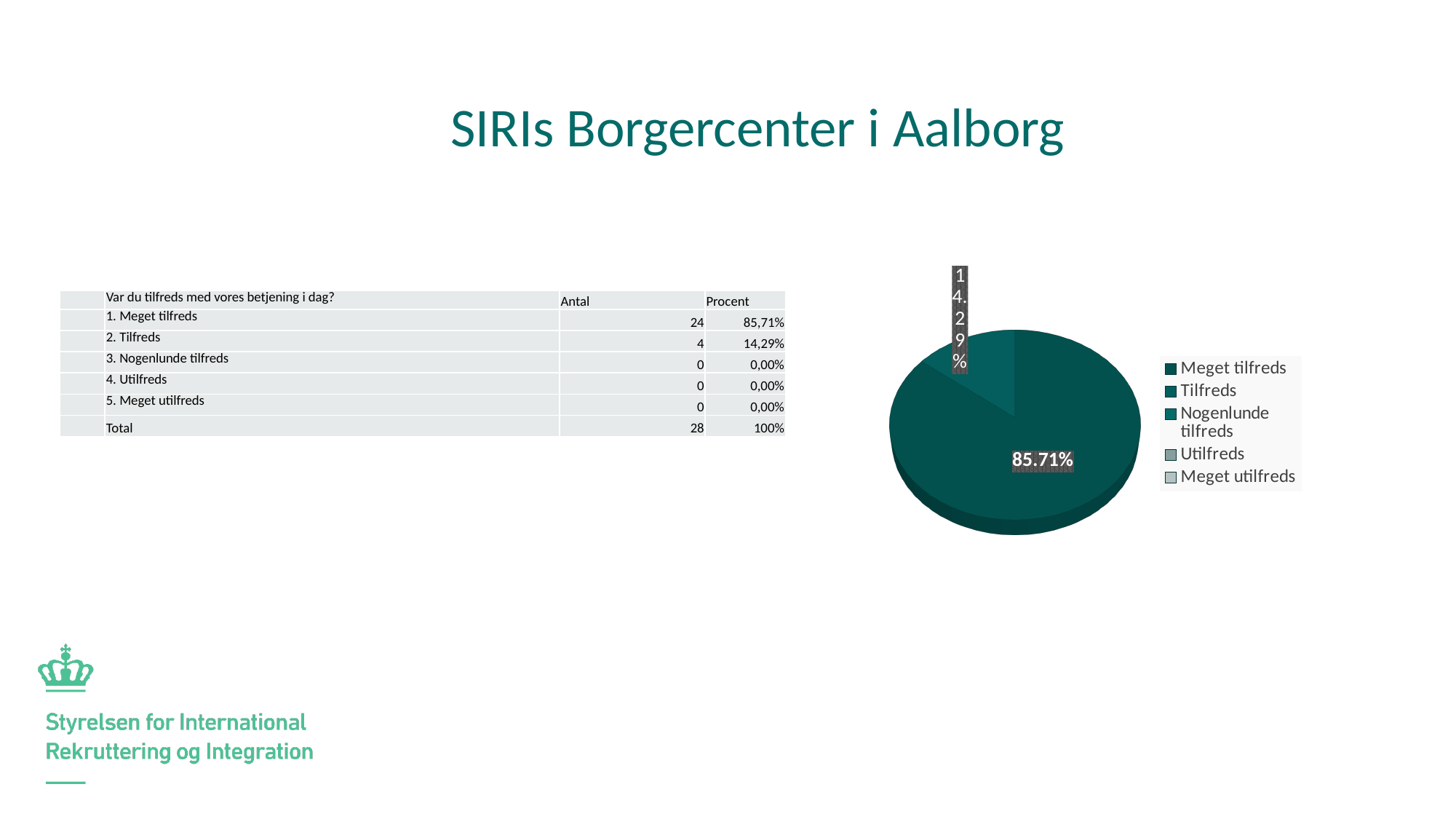
How many entries does the legend of the pie chart list? 5 How many slices are visible in the pie chart? 2 Which legend entry is listed last in the pie chart's legend? Meget utilfreds What is the title of the slide containing the pie chart? SIRIs Borgercenter i Aalborg What share of the pie does the Meget tilfreds slice represent? 85.71% Which is larger in the pie chart, the Meget tilfreds slice or the Tilfreds slice? Meget tilfreds What kind of chart is shown on the slide? pie chart What is the difference between the Meget tilfreds share and the Tilfreds share in the pie chart? 71.42% What share of the pie does the Tilfreds slice represent? 14.29% Is the share for Meget tilfreds greater or less than 50%? greater Which category has the largest slice in the pie chart? Meget tilfreds